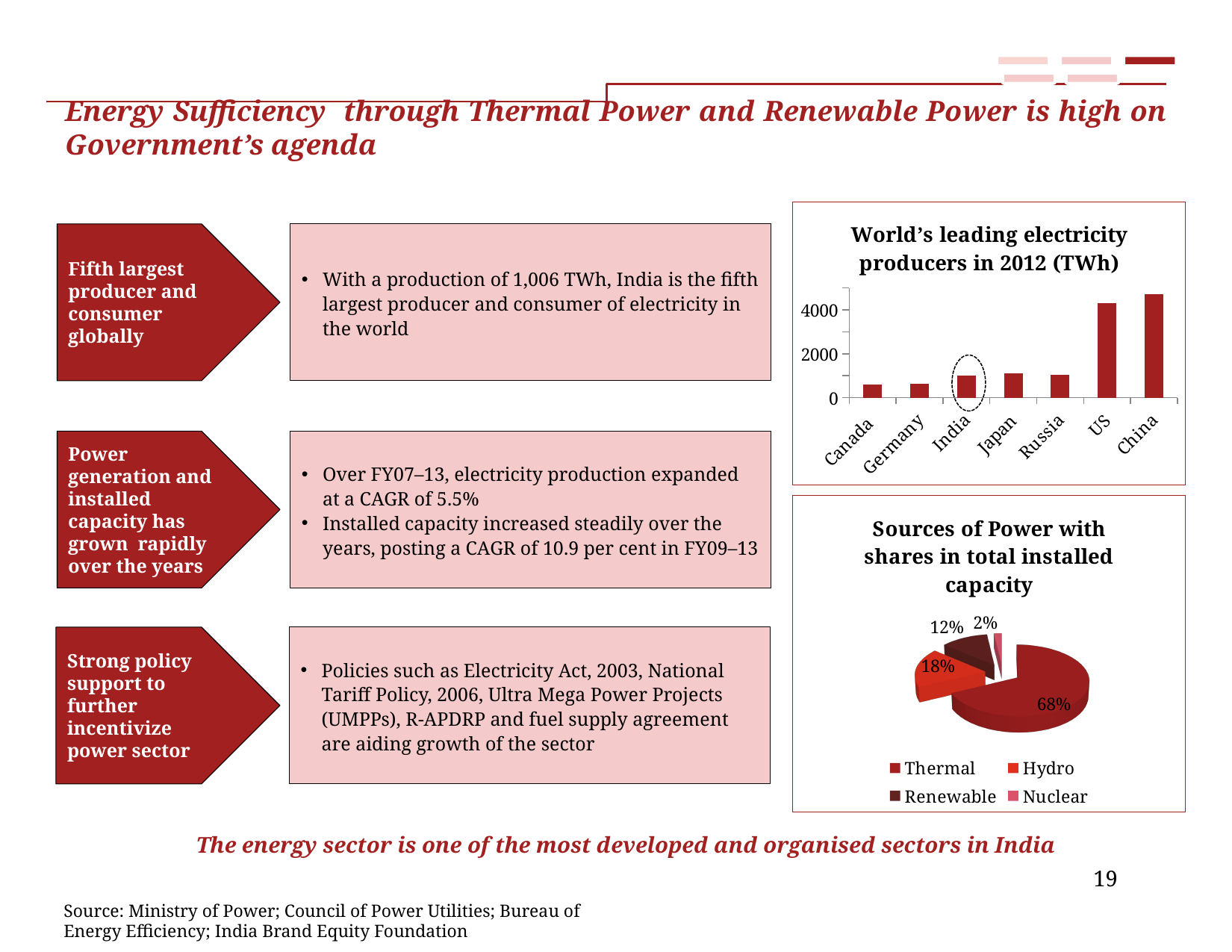
What kind of chart is 'Sources of Power with shares in total installed capacity'? pie chart What kind of chart is 'World's leading electricity producers in 2012 (TWh)'? bar chart In the 'Sources of Power with shares in total installed capacity' chart, what share does Hydro have? 18% In the 'World's leading electricity producers in 2012 (TWh)' chart, how many countries are shown? 7 In the 'Sources of Power with shares in total installed capacity' chart, what share does Thermal have? 68% In the 'World's leading electricity producers in 2012 (TWh)' chart, is the value for the US greater or less than 4000? greater In the 'World's leading electricity producers in 2012 (TWh)' chart, which is larger, the value for China or the value for Russia? China In the 'Sources of Power with shares in total installed capacity' chart, which source has the smallest share? Nuclear In the 'World's leading electricity producers in 2012 (TWh)' chart, which country has the highest value? China In the 'Sources of Power with shares in total installed capacity' chart, what is the difference between the Thermal and Hydro shares? 50% In the 'World's leading electricity producers in 2012 (TWh)' chart, is the value for India greater or less than 2000? less How many entries does the legend of the 'Sources of Power with shares in total installed capacity' chart list? 4